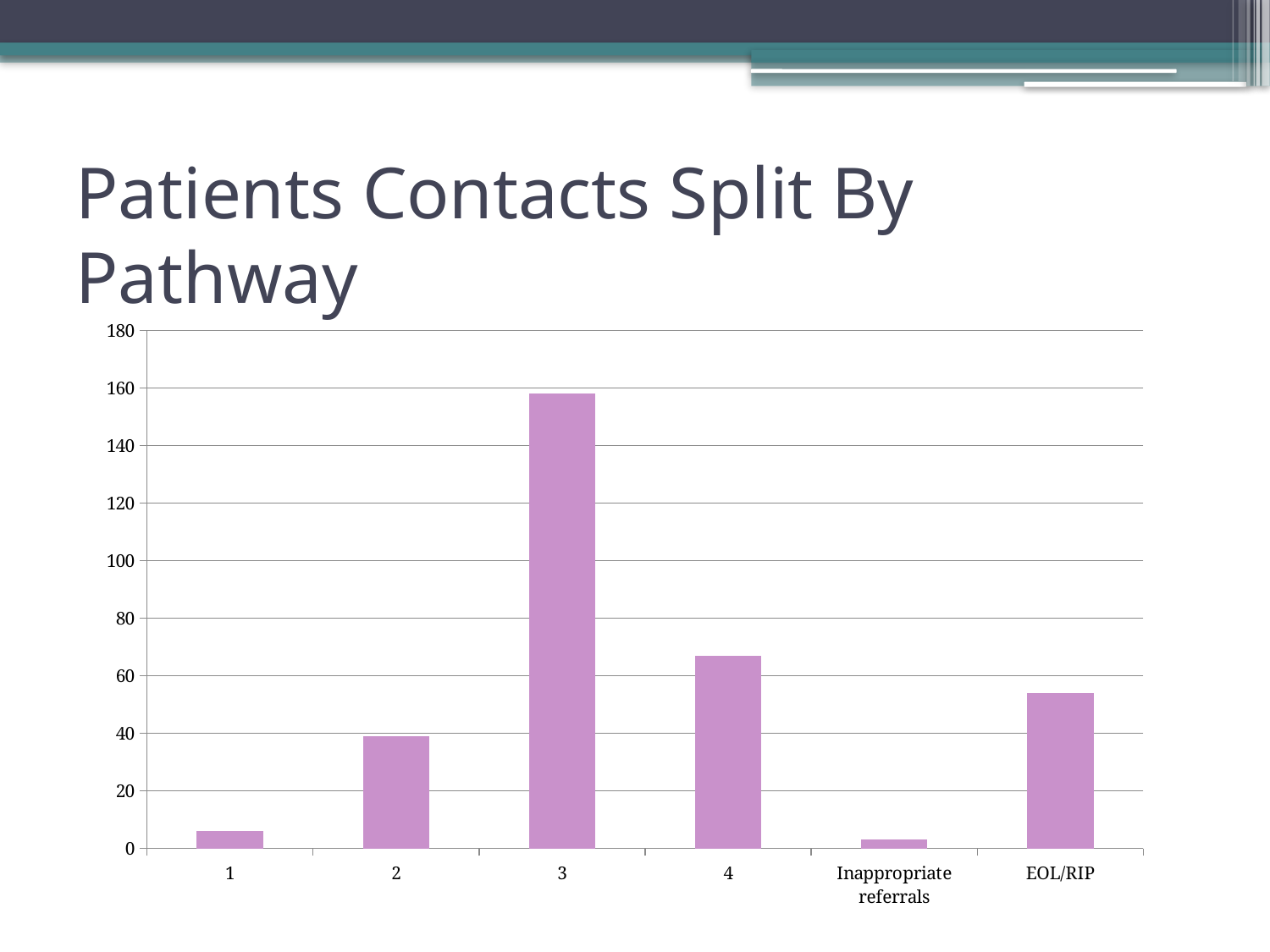
What kind of chart is shown on the slide? bar chart Which is larger, the value for category 2 or the value for EOL/RIP? EOL/RIP Is the value for EOL/RIP greater or less than 40? greater Is the value for category 4 greater or less than 80? less Which category has the lowest value? Inappropriate referrals Is the value for category 1 greater or less than 20? less What is the title of the slide? Patients Contacts Split By Pathway Which category has the highest value? 3 Which is larger, the value for category 4 or the value for EOL/RIP? 4 How many categories are shown on the x axis of the chart? 6